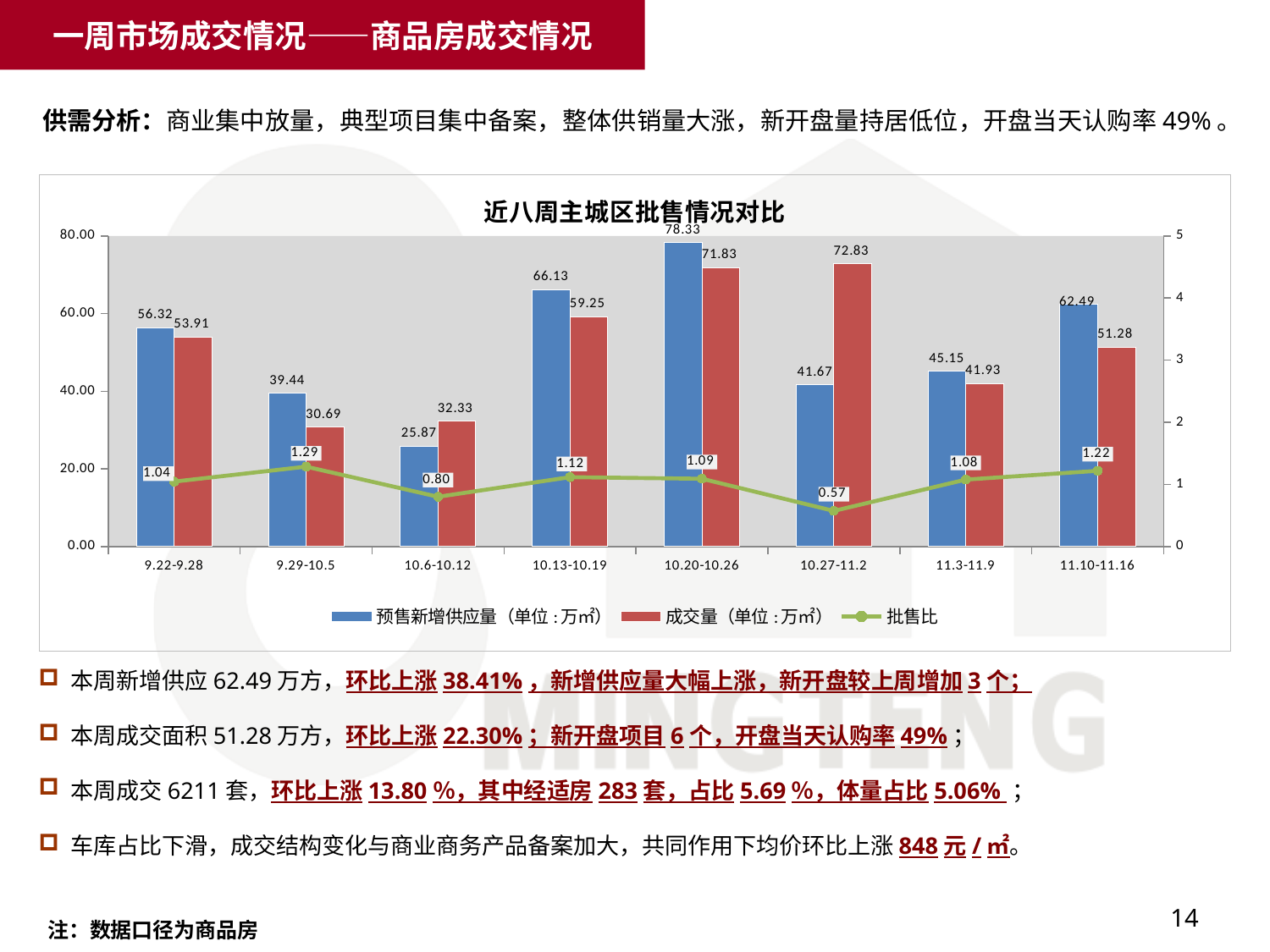
What is the 批售比 value for 10.27-11.2? 0.57 What is the difference between 预售新增供应量 and 成交量 for 9.29-10.5? 8.75 How many weekly periods are shown on the x axis? 8 Which period has the highest 批售比? 9.29-10.5 How many series does the legend list? 3 Which period has the highest 成交量? 10.27-11.2 For 10.27-11.2, which is larger: 预售新增供应量 or 成交量? 成交量 What is the 成交量 value for 11.10-11.16? 51.28 What is the title of the chart? 近八周主城区批售情况对比 Which period has the lowest 预售新增供应量? 10.6-10.12 What is the 预售新增供应量 value for 10.20-10.26? 78.33 What type of chart is shown on the slide? Combined bar and line chart